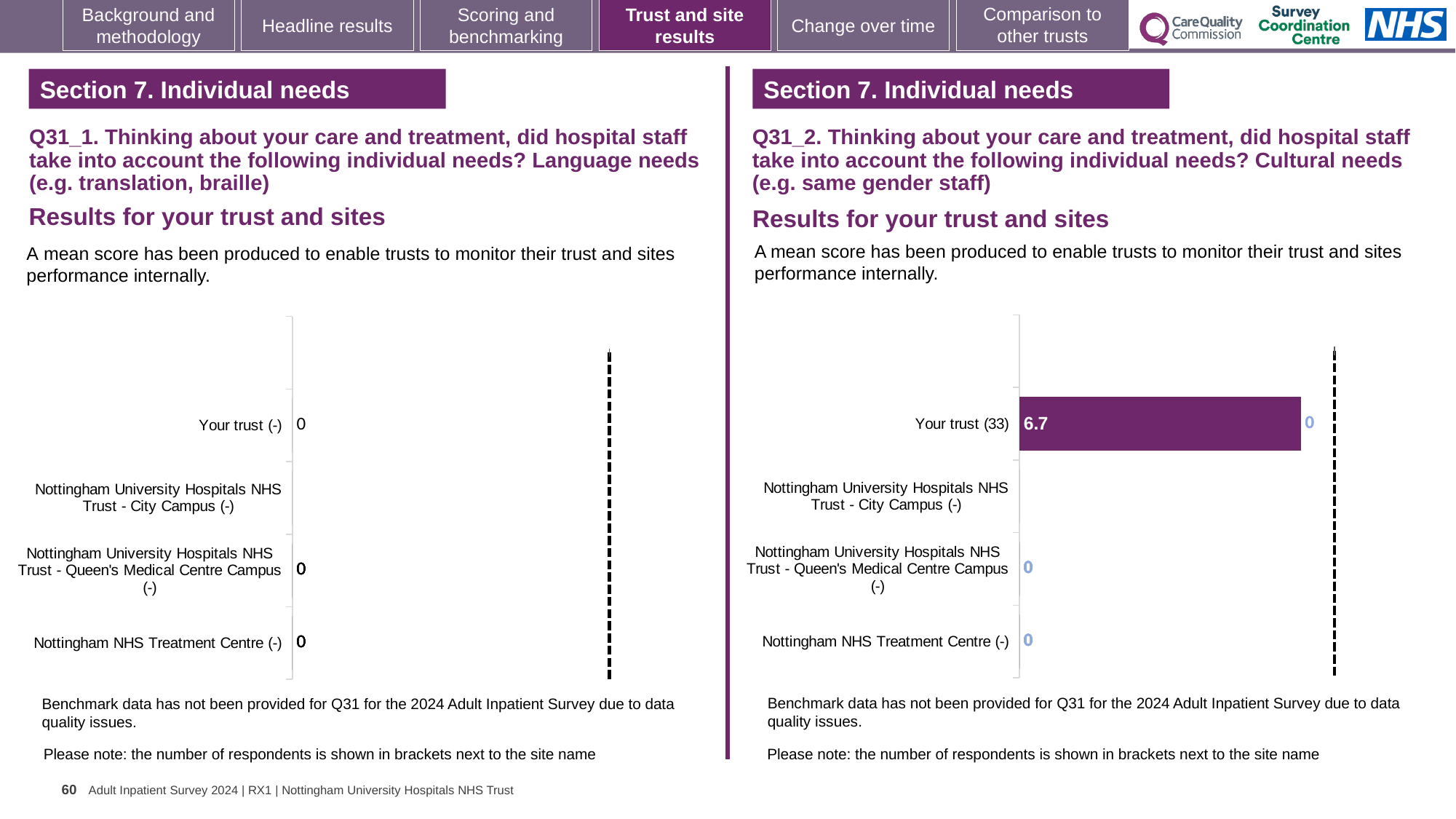
On the right-hand chart (Q31_2, Cultural needs), what is the value for Nottingham NHS Treatment Centre (-)? 0 What kind of chart is the right-hand chart (Q31_2, Cultural needs)? Bar chart How many categories are listed on the left-hand chart (Q31_1, Language needs)? 4 On the right-hand chart (Q31_2, Cultural needs), what is the difference between the value for Your trust (33) and the value for Nottingham NHS Treatment Centre (-)? 6.7 On the left-hand chart (Q31_1, Language needs), what is the value for Nottingham NHS Treatment Centre (-)? 0 On the right-hand chart (Q31_2, Cultural needs), which is larger: the value for Your trust (33) or the value for Nottingham University Hospitals NHS Trust - Queen's Medical Centre Campus (-)? Your trust (33) On the right-hand chart (Q31_2, Cultural needs), what is the value for Your trust (33)? 6.7 On the left-hand chart (Q31_1, Language needs), what is the value for Your trust (-)? 0 How many categories are listed on the right-hand chart (Q31_2, Cultural needs)? 4 On the right-hand chart (Q31_2, Cultural needs), which category has the highest value? Your trust (33) On the right-hand chart (Q31_2, Cultural needs), how many respondents are shown in brackets for Your trust? 33 On the right-hand chart (Q31_2, Cultural needs), what is the value for Nottingham University Hospitals NHS Trust - Queen's Medical Centre Campus (-)? 0